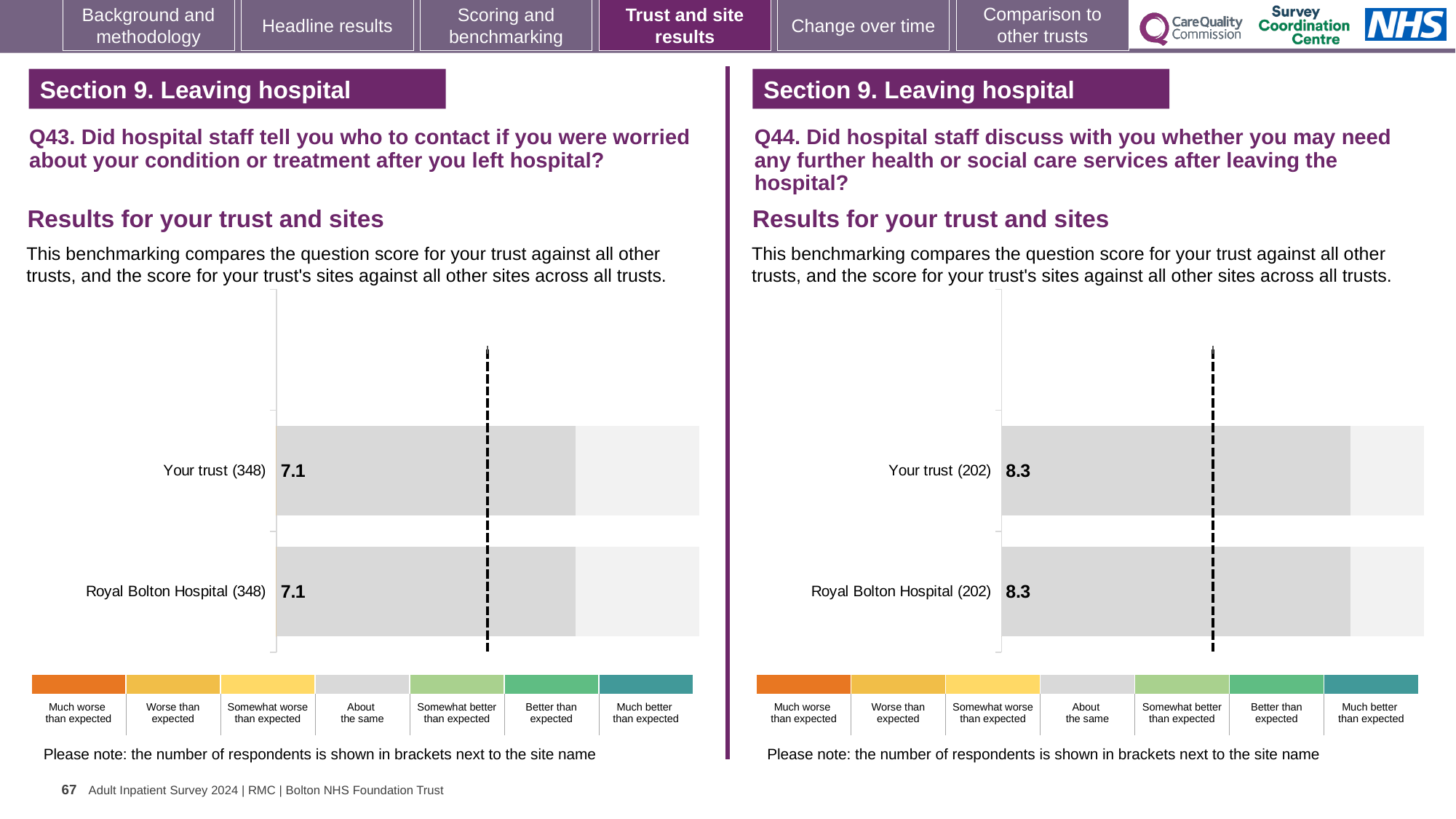
What kind of chart is used on the left (Q43)? Bar chart Is the score for Your trust on the right chart (Q44) larger or smaller than the score for Your trust on the left chart (Q43)? Larger On the left chart (Q43), what is the score for Your trust? 7.1 How many bars are plotted on the left chart (Q43)? 2 On the left chart (Q43), what is the score for Royal Bolton Hospital? 7.1 On the right chart (Q44), what is the score for Royal Bolton Hospital? 8.3 On the left chart (Q43), what is the difference between the score for Your trust and the score for Royal Bolton Hospital? 0 On the right chart (Q44), what is the score for Your trust? 8.3 On the left chart (Q43), how many respondents are shown in brackets next to Royal Bolton Hospital? 348 On the right chart (Q44), what is the difference between the score for Your trust and the score for Royal Bolton Hospital? 0 How many bars are plotted on the right chart (Q44)? 2 On the right chart (Q44), how many respondents are shown in brackets next to Your trust? 202